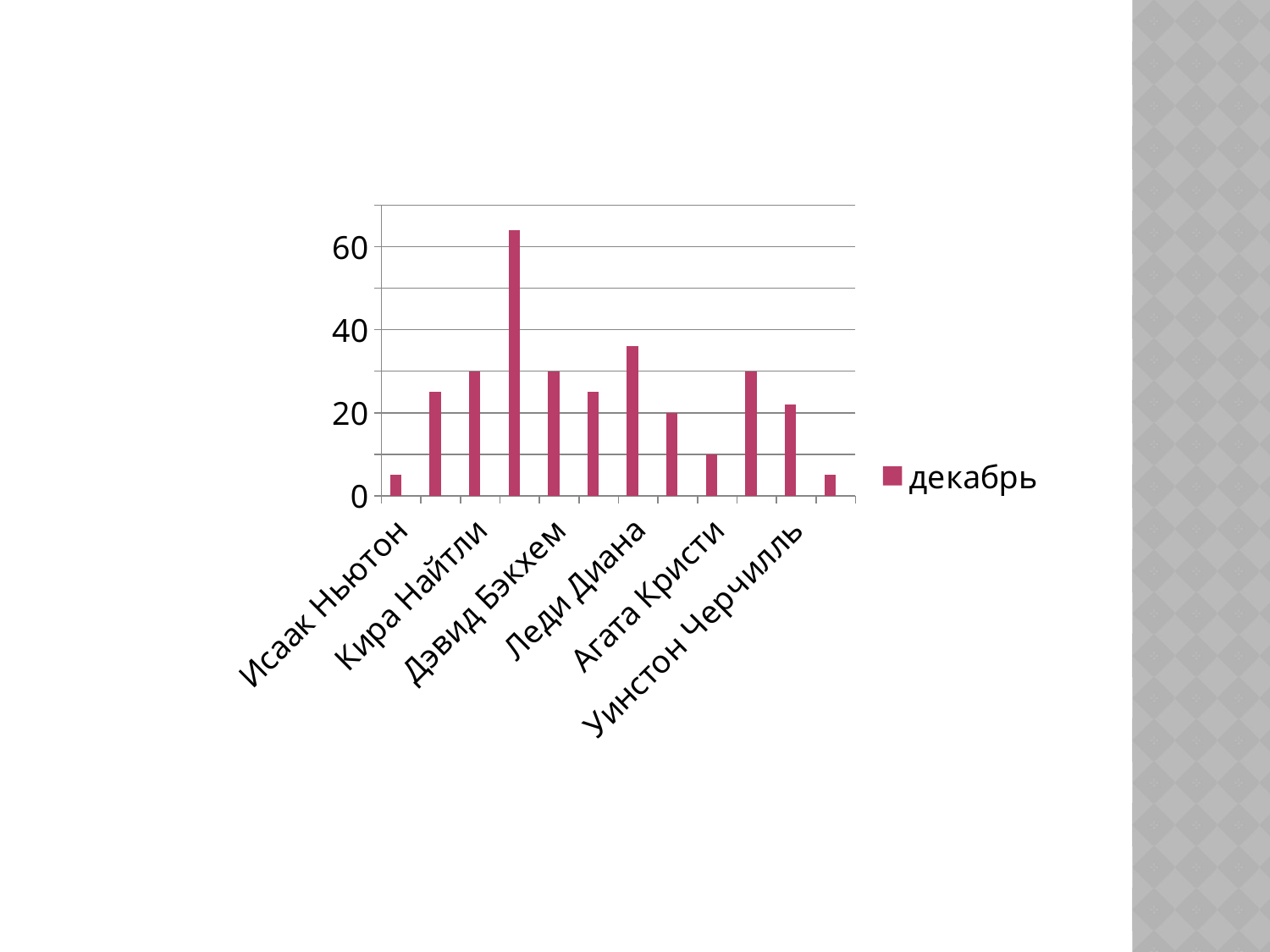
What is the name of the series shown in the legend? декабрь How many series does the legend list? 1 Which has the larger value, Исаак Ньютон or Кира Найтли? Кира Найтли Is the value for Исаак Ньютон greater or less than 20? less How many bars are plotted in the chart? 12 Is the value for Кира Найтли greater or less than 40? less What kind of chart is shown on the slide? bar chart Is the value for Дэвид Бэкхем greater or less than 20? greater Which has the larger value, Леди Диана or Агата Кристи? Леди Диана